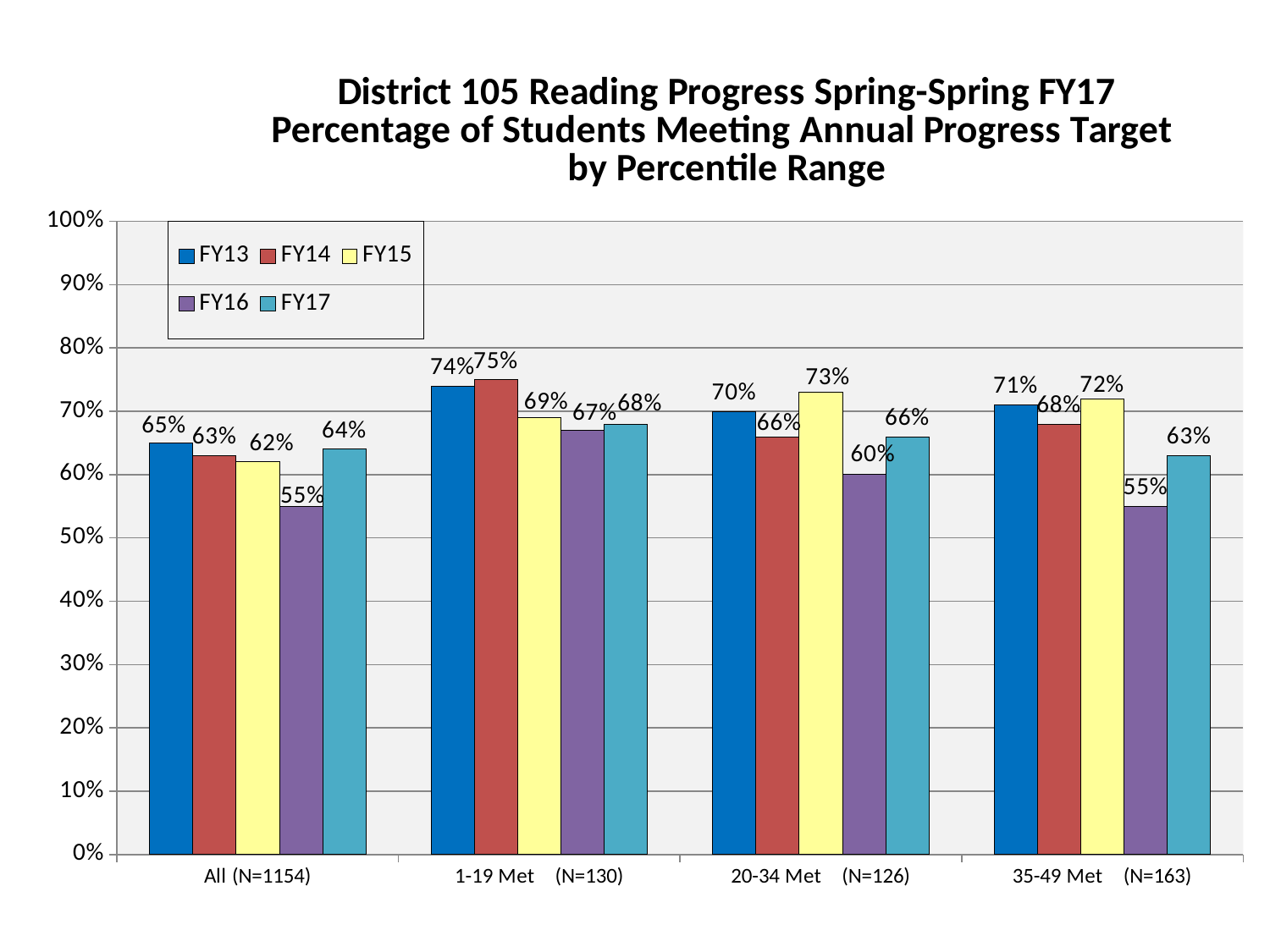
Which series has the lowest value in the 35-49 Met (N=163) category? FY16 What is the difference between the FY15 and FY16 values in the 20-34 Met (N=126) category? 13% What is the FY16 value for the 20-34 Met (N=126) category? 60% How many series does the legend list? 5 What is the FY17 value for the All (N=1154) category? 64% How many categories are shown on the x axis? 4 Which category has the highest FY13 value? 1-19 Met (N=130) Is the FY16 value for the All (N=1154) category greater or less than 60%? less What kind of chart is shown on the slide? bar chart Which series has the highest value in the 1-19 Met (N=130) category? FY14 Which is larger in the All (N=1154) category, the FY13 value or the FY17 value? FY13 What is the FY15 value for the 35-49 Met (N=163) category? 72%